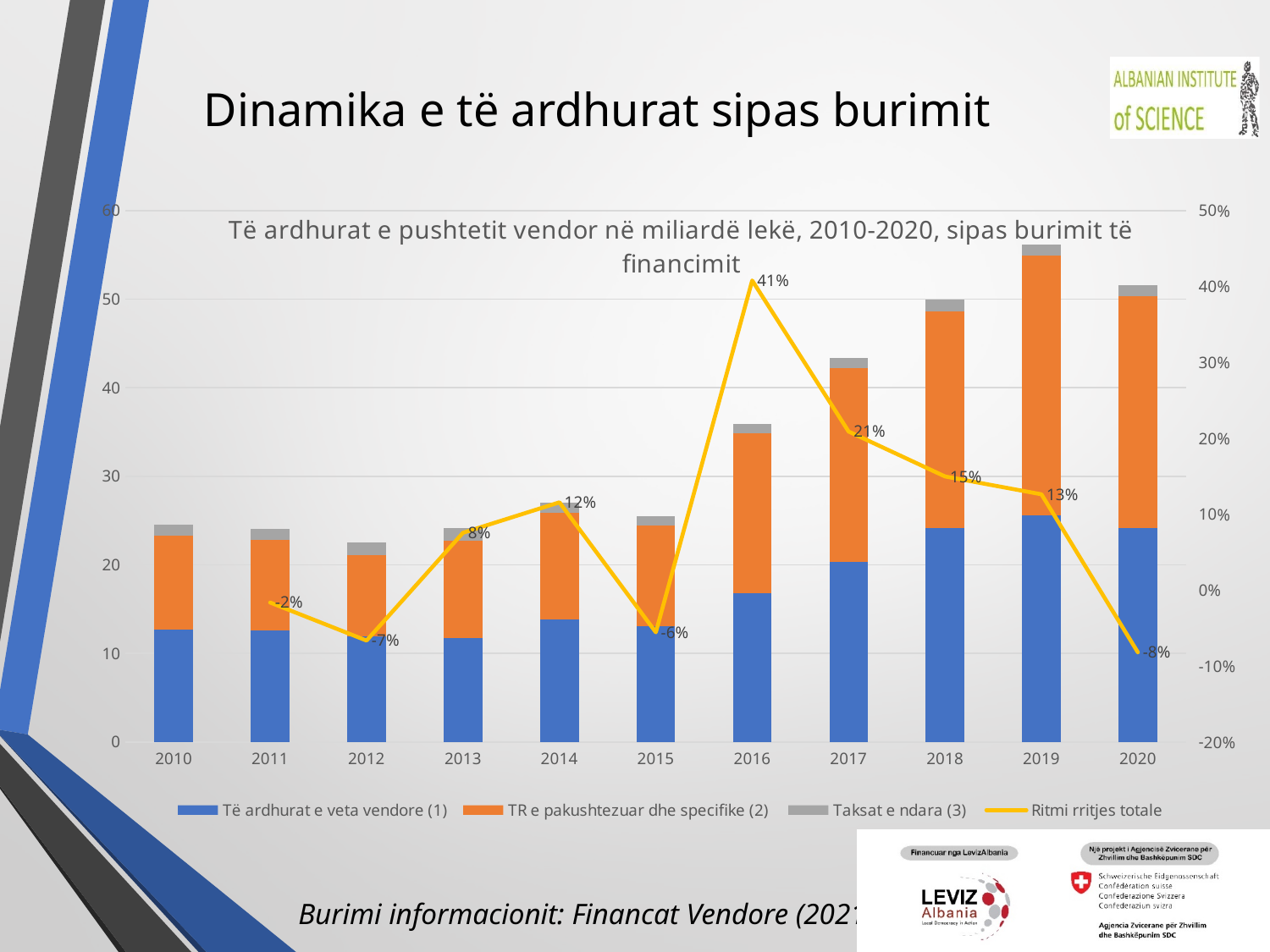
How many series does the legend list? 4 In which year is 'Ritmi rritjes totale' highest? 2016 What is the value of 'Ritmi rritjes totale' for 2016? 41% Is the total height of the stacked bar for 2012 greater or less than 30? less What is the value of 'Ritmi rritjes totale' for 2020? -8% Is the total height of the stacked bar for 2019 greater or less than 50? greater In which year is 'Ritmi rritjes totale' lowest? 2020 What is the difference between 'Ritmi rritjes totale' in 2016 and in 2017? 20 percentage points Which is larger, 'Ritmi rritjes totale' in 2014 or in 2018? 2018 What kind of chart is shown on the slide? Combined stacked bar and line chart How many years are shown on the x axis? 11 What is the value of 'Ritmi rritjes totale' for 2013? 8%